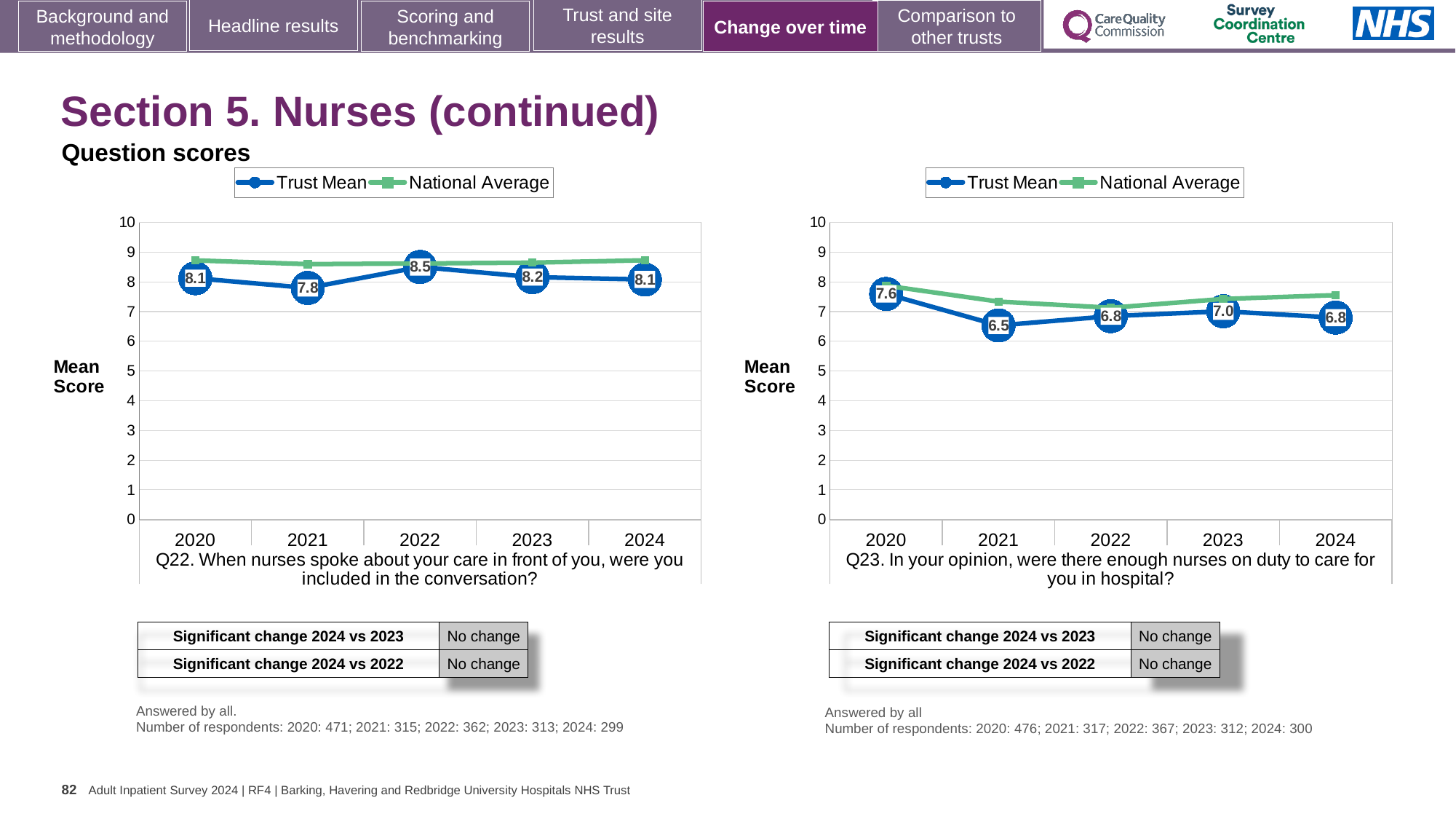
In the Q23 chart (right), which year has the lowest Trust Mean? 2021 In the Q22 chart (left), what is the Trust Mean value for 2022? 8.5 In the Q23 chart (right), is the National Average for 2024 greater or less than 7? greater In the Q22 chart (left), what is the difference between the Trust Mean for 2022 and 2021? 0.7 What kind of chart is the Q22 chart (left)? Line chart In the Q22 chart (left), which year has the lowest Trust Mean? 2021 How many series does the legend of the Q22 chart (left) list? 2 In the Q23 chart (right), is the Trust Mean for 2020 larger or smaller than the Trust Mean for 2023? larger In the Q22 chart (left), what is the Trust Mean value for 2021? 7.8 How many years are plotted on the x axis of the Q23 chart (right)? 5 In the Q22 chart (left), which year has the highest Trust Mean? 2022 In the Q23 chart (right), what is the Trust Mean value for 2020? 7.6